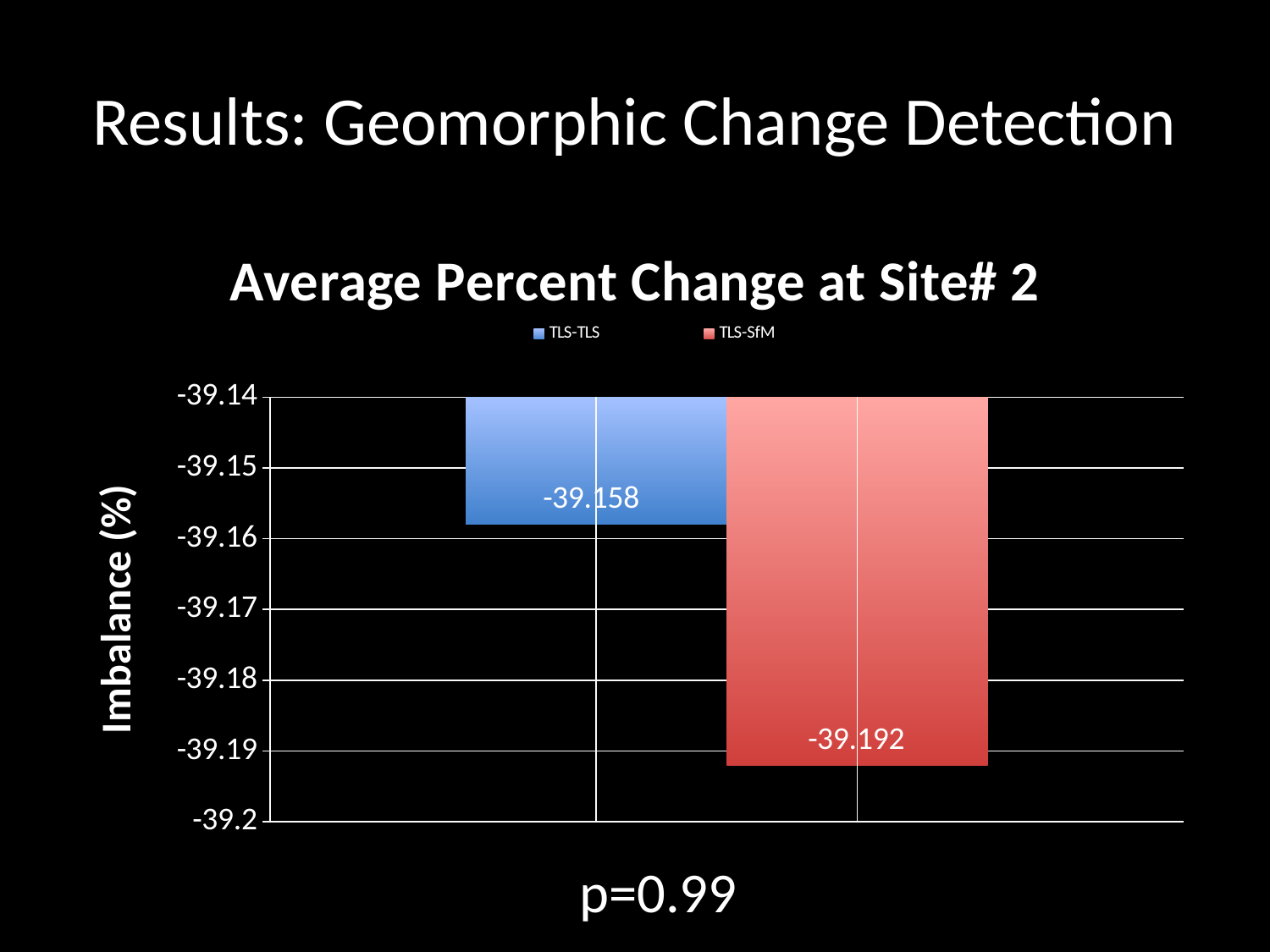
How many series does the legend list? 2 What kind of chart is shown on the slide? Bar chart Which series has the lowest (most negative) value in the chart? TLS-SfM Is the value for TLS-SfM greater or less than -39.18? less Which series has the higher (less negative) value, TLS-TLS or TLS-SfM? TLS-TLS What is the value for TLS-TLS in the Average Percent Change at Site# 2 chart? -39.158 How many bars are plotted in the chart? 2 Is the value for TLS-TLS greater or less than -39.17? greater Which series has the highest value in the chart? TLS-TLS What is the value for TLS-SfM in the Average Percent Change at Site# 2 chart? -39.192 What is the difference between the TLS-TLS value and the TLS-SfM value? 0.034 What is the label of the vertical axis of the chart? Imbalance (%)